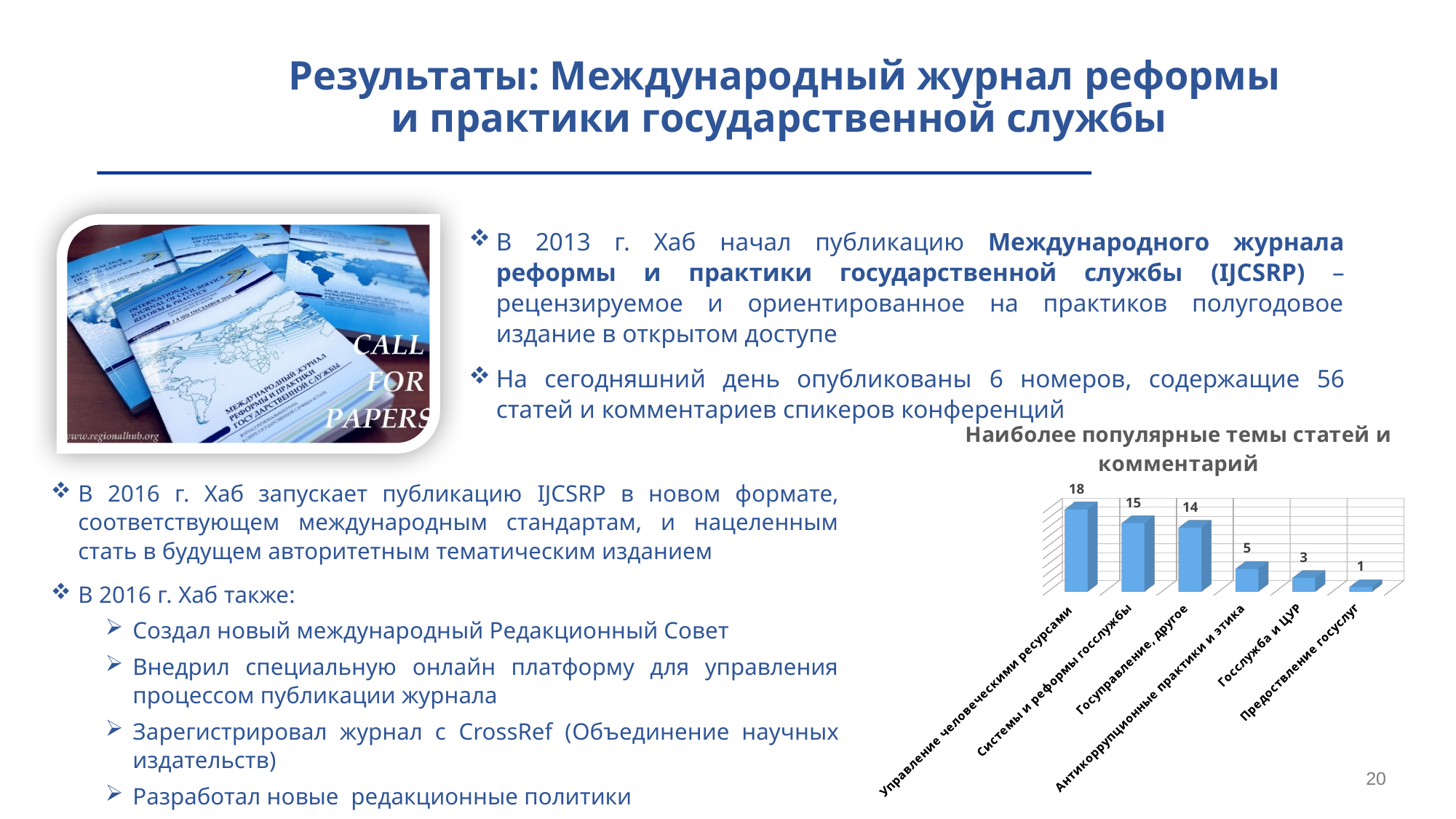
Do the values rise or fall from left to right across the categories in the chart? Fall What kind of chart is shown on the slide? Bar chart What is the difference between the values for "Управление человеческими ресурсами" and "Госуправление, другое"? 4 Which is larger: the value for "Госслужба и ЦУР" or the value for "Антикоррупционные практики и этика"? Антикоррупционные практики и этика Which category has the lowest value in the chart? Предоствление госуслуг What is the title of the chart on the slide? Наиболее популярные темы статей и комментарий What is the value for "Антикоррупционные практики и этика" in the chart? 5 What is the value for "Предоставление госуслуг" in the chart? 1 How many categories are shown in the chart? 6 What is the value for "Управление человеческими ресурсами" in the chart? 18 What is the value for "Системы и реформы госслужбы" in the chart? 15 Which category has the highest value in the chart? Управление человеческими ресурсами